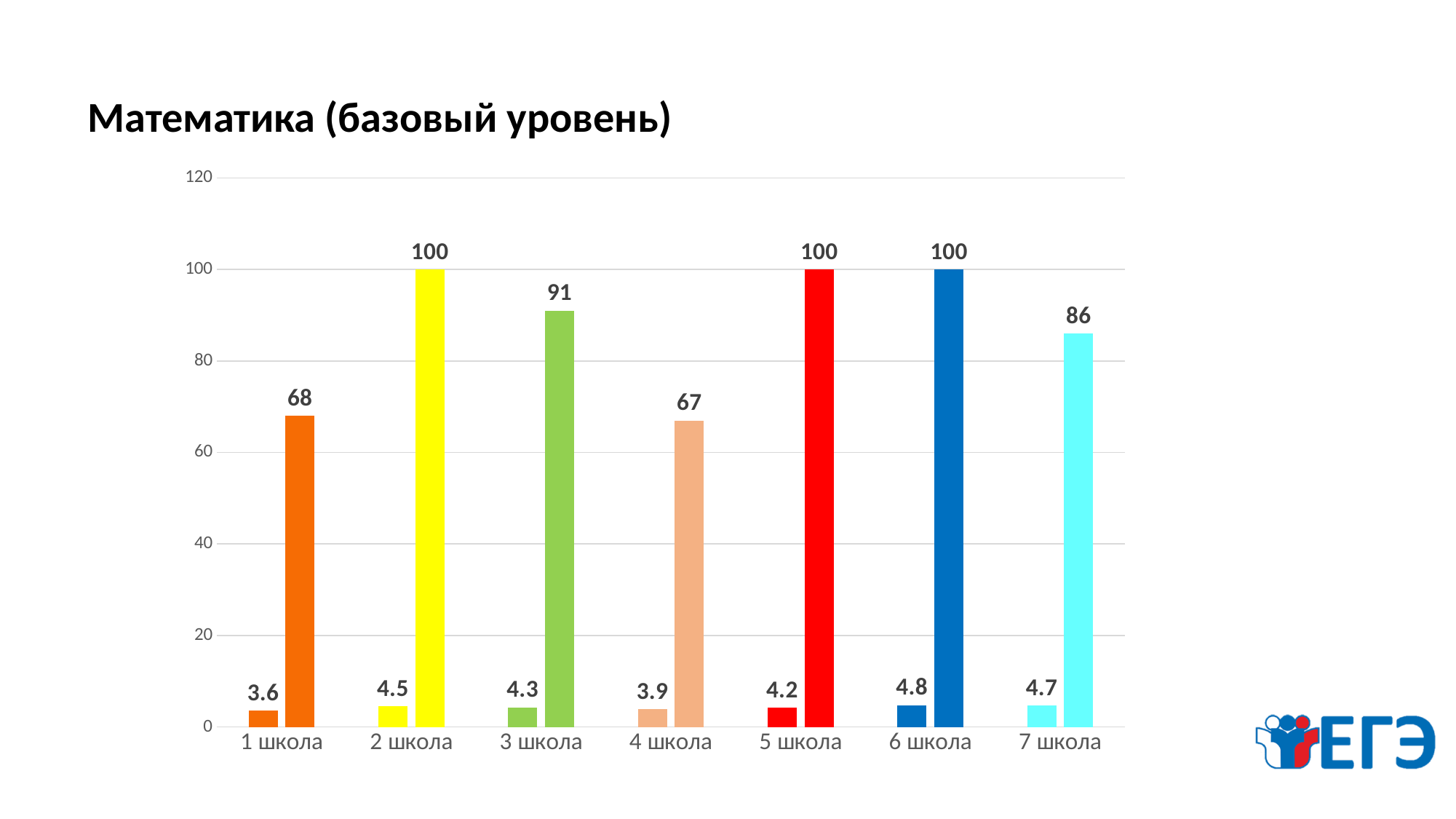
How many bars are plotted for each school? 2 What is the value of the shorter (first) bar for 3 школа? 4.3 Which school has the lowest value among the shorter (first) bars? 1 школа Is the taller bar for 4 школа greater or less than 80? less What type of chart is shown on the slide? bar chart What is the difference between the taller bars of 2 школа and 1 школа? 32 What is the title of the chart? Математика (базовый уровень) Which school has the highest value among the shorter (first) bars? 6 школа Which is larger: the taller bar for 3 школа or the taller bar for 7 школа? 3 школа What is the value of the taller (second) bar for 1 школа? 68 What is the value of the taller (second) bar for 7 школа? 86 How many schools (categories) are shown on the x axis? 7